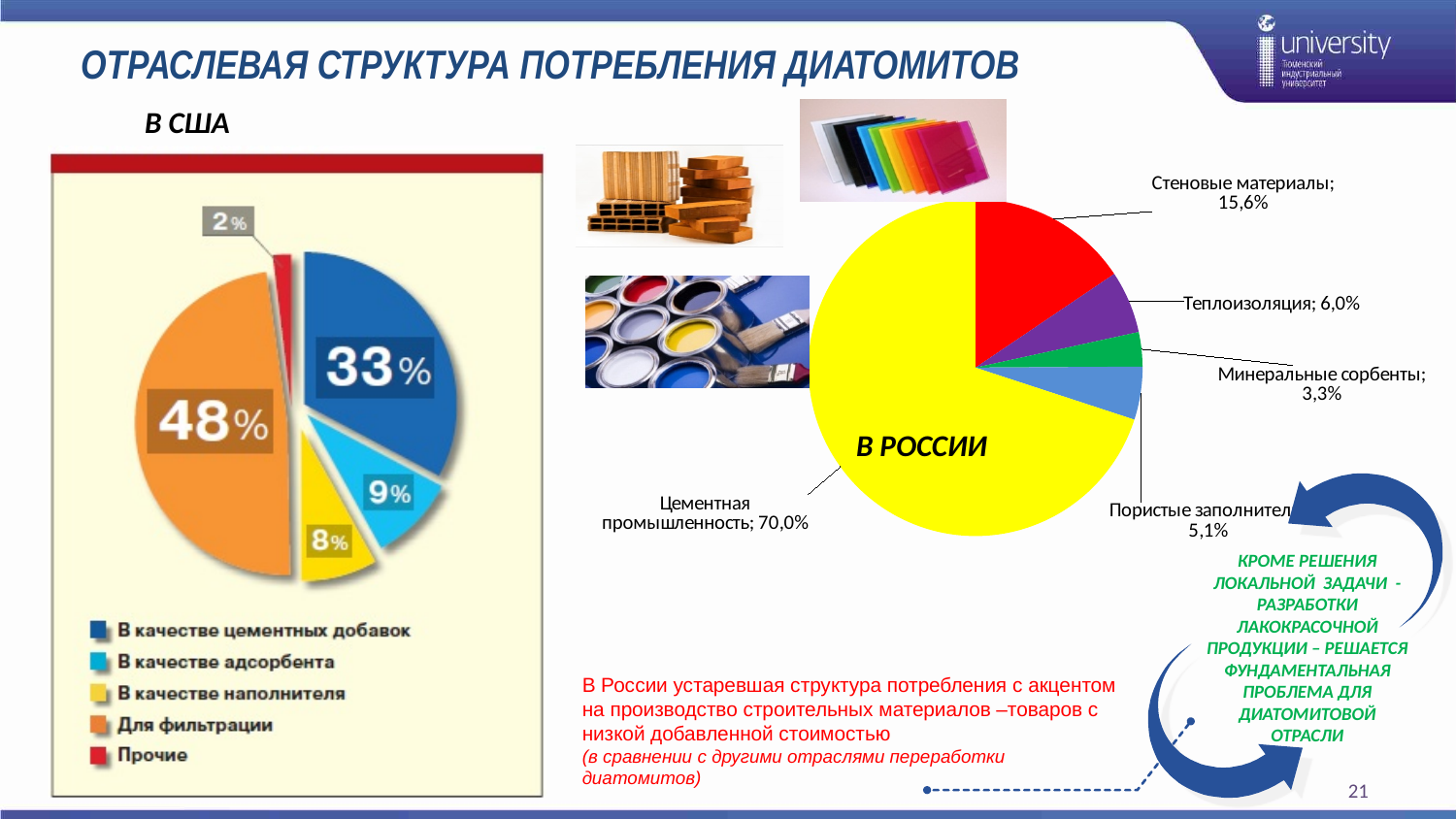
In the 'В РОССИИ' pie chart, which category has the smallest share? Минеральные сорбенты In the 'В РОССИИ' pie chart, what share is shown for 'Цементная промышленность'? 70,0% In the 'В США' pie chart, what share is shown for 'Для фильтрации'? 48% In the 'В РОССИИ' pie chart, what share is shown for 'Стеновые материалы'? 15,6% In the 'В США' pie chart, what is the difference between the shares for 'В качестве адсорбента' and 'В качестве наполнителя'? 1% What type of chart is used for the 'В РОССИИ' data? Pie chart In the 'В США' pie chart, which category has the smallest share? Прочие In the 'В РОССИИ' pie chart, what is the difference between the shares for 'Стеновые материалы' and 'Теплоизоляция'? 9,6% In the 'В РОССИИ' pie chart, which is larger: 'Теплоизоляция' or 'Пористые заполнители'? Теплоизоляция In the 'В США' pie chart, which category has the largest share? Для фильтрации How many categories does the legend of the 'В США' pie chart list? 5 In the 'В США' pie chart, what share is shown for 'В качестве цементных добавок'? 33%